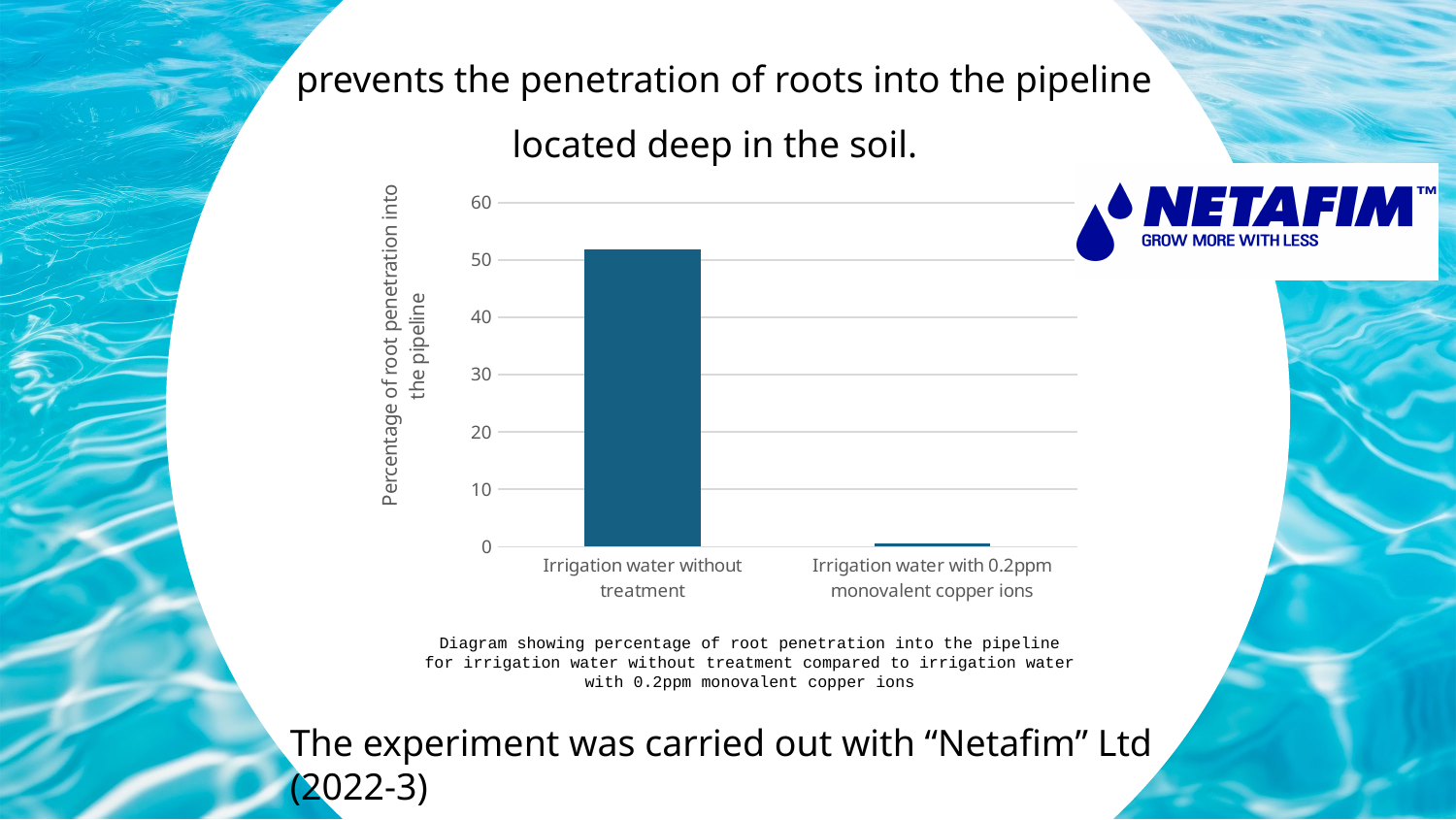
What is the highest value shown on the vertical axis of the chart? 60 Which category has the highest percentage of root penetration into the pipeline? Irrigation water without treatment Is the value for irrigation water without treatment greater or less than 60? less Is the value for irrigation water with 0.2ppm monovalent copper ions greater or less than 10? less Is the value for irrigation water without treatment greater or less than 40? greater Which category has the lowest percentage of root penetration into the pipeline? Irrigation water with 0.2ppm monovalent copper ions What kind of chart is shown on the slide? bar chart How many categories are plotted in the chart? 2 Which is larger: the value for irrigation water without treatment or the value for irrigation water with 0.2ppm monovalent copper ions? Irrigation water without treatment What is the label of the vertical axis of the chart? Percentage of root penetration into the pipeline Do the values rise or fall from the left category to the right category? fall